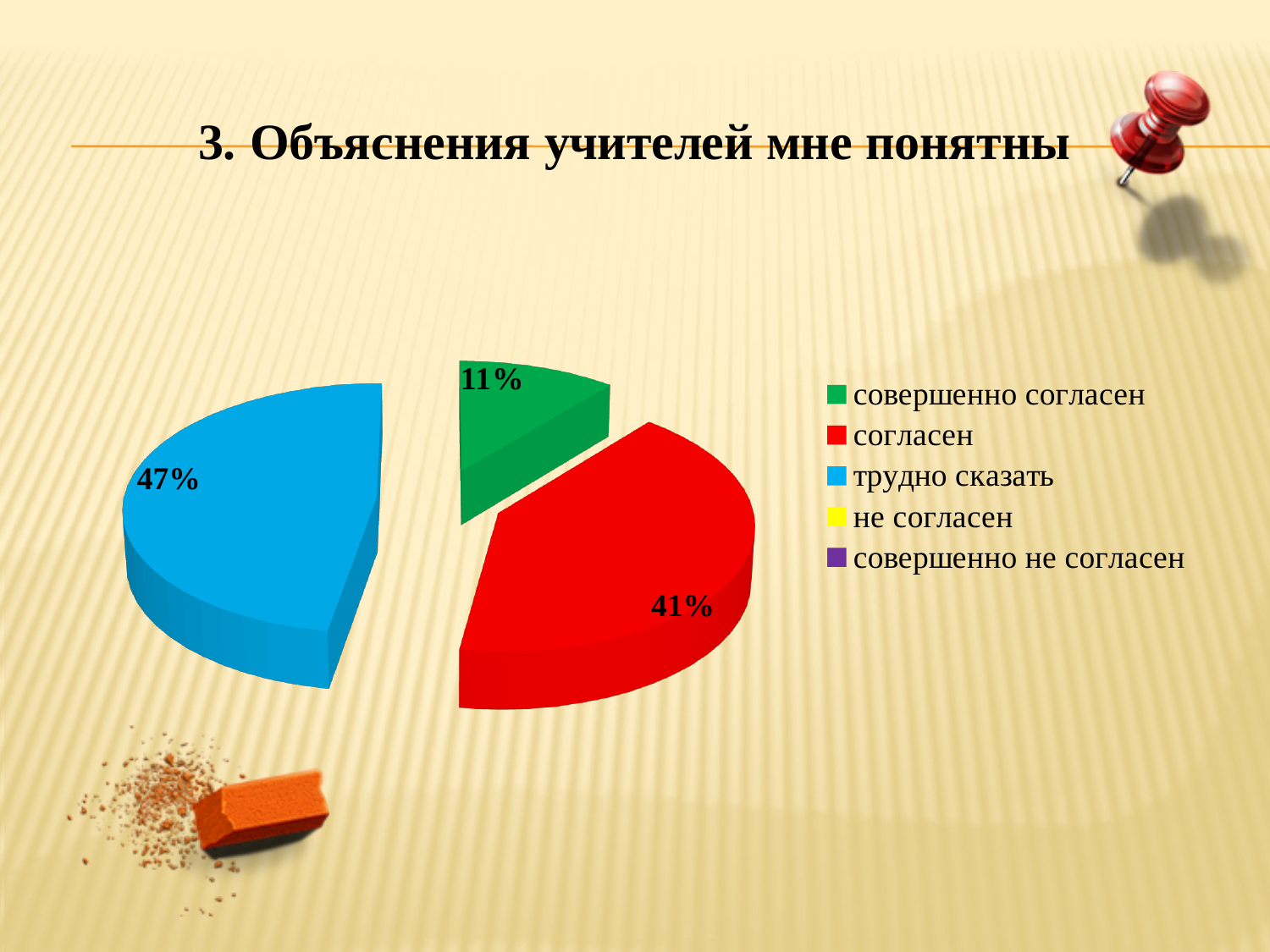
Which labelled slice is the smallest? совершенно согласен How many entries does the legend list? 5 What is the difference in percentage points between "трудно сказать" and "согласен"? 6 How many slices with data labels are visible in the pie? 3 What type of chart is shown on the slide? pie chart What colour is the slice for "трудно сказать"? blue What is the difference in percentage points between "согласен" and "совершенно согласен"? 30 What percentage is shown for "трудно сказать"? 47% What percentage is shown for "согласен"? 41% What percentage is shown for "совершенно согласен"? 11% Which category has the largest slice of the pie? трудно сказать Which is larger, the slice for "согласен" or the slice for "совершенно согласен"? согласен